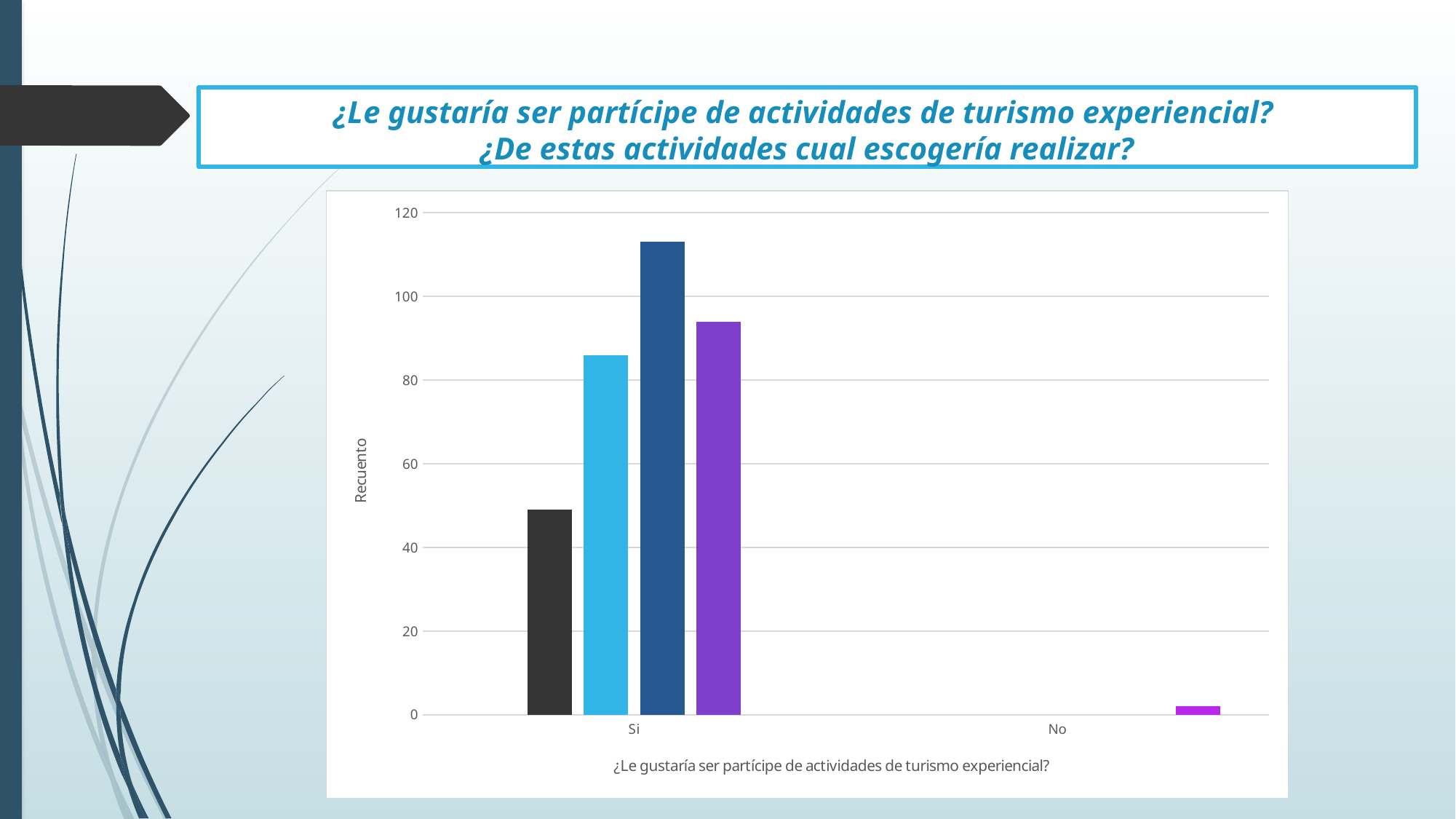
Which bar colour reaches the highest value in the chart? dark blue What are the two categories on the x axis of the chart? Si and No Is the value of the dark gray bar for Si greater or less than 60? less Is the value of the purple bar for Si greater or less than 100? less Which category, Si or No, has the tallest bar in the chart? Si Is the value of the light blue bar for Si greater or less than 80? greater What kind of chart is shown on the slide? bar chart Which is larger for Si, the light blue bar or the purple bar? the purple bar What is the label of the vertical axis of the chart? Recuento How many categories are shown on the x axis of the chart? 2